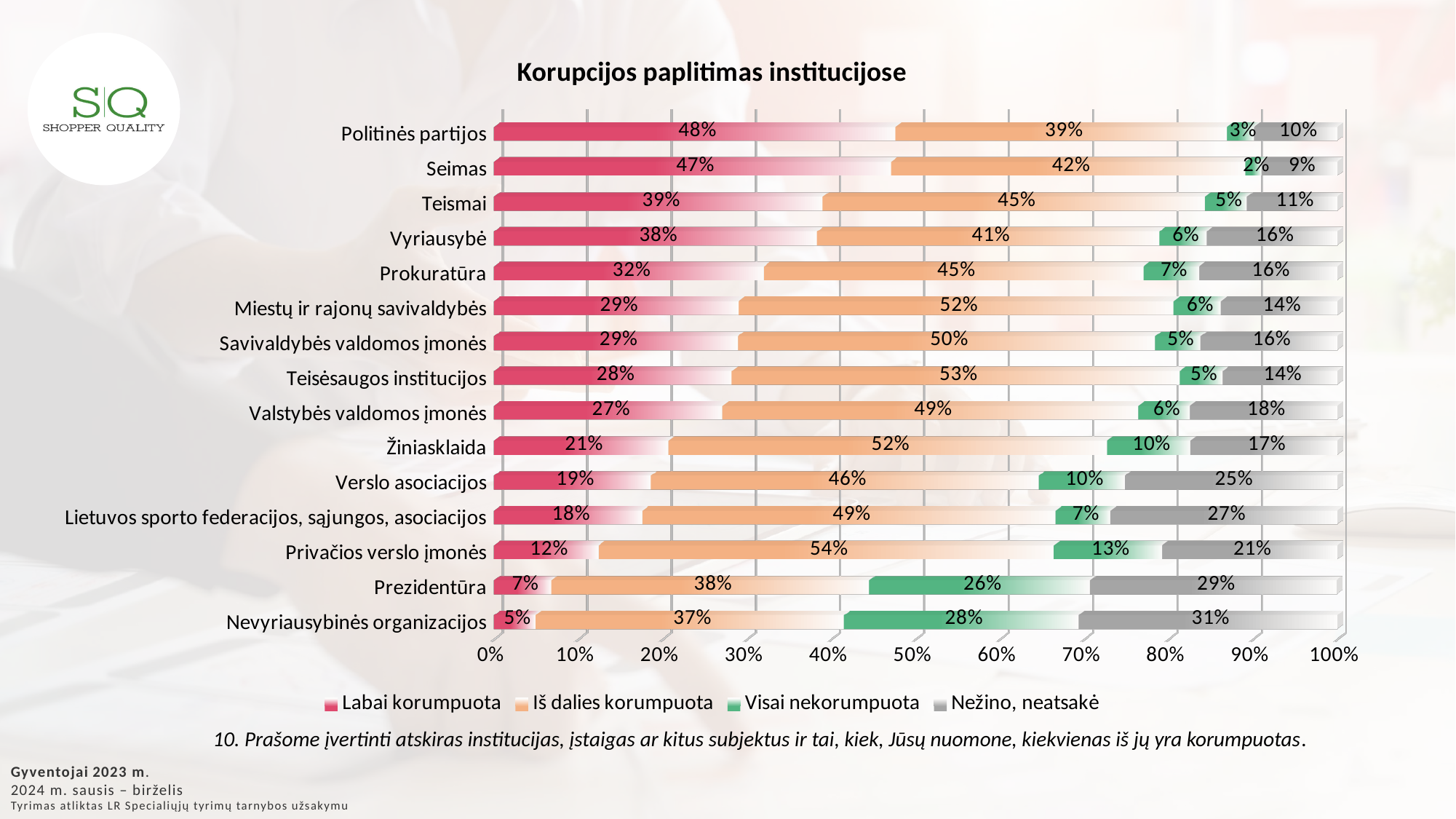
Which institution has the highest 'Labai korumpuota' value? Politinės partijos What type of chart is shown on the slide? Stacked bar chart What is the title of the chart? Korupcijos paplitimas institucijose Which institution has the highest 'Nežino, neatsakė' value? Nevyriausybinės organizacijos How many institutions (categories) are shown in the chart? 15 What is the 'Visai nekorumpuota' value for Prezidentūra? 26% What is the 'Labai korumpuota' value for Seimas? 47% Which institution has the lowest 'Labai korumpuota' value? Nevyriausybinės organizacijos What is the difference between the 'Labai korumpuota' values for Teismai and Prezidentūra? 32 percentage points How many series does the legend list? 4 What is the 'Iš dalies korumpuota' value for Privačios verslo įmonės? 54% Which has a larger 'Visai nekorumpuota' value, Žiniasklaida or Vyriausybė? Žiniasklaida